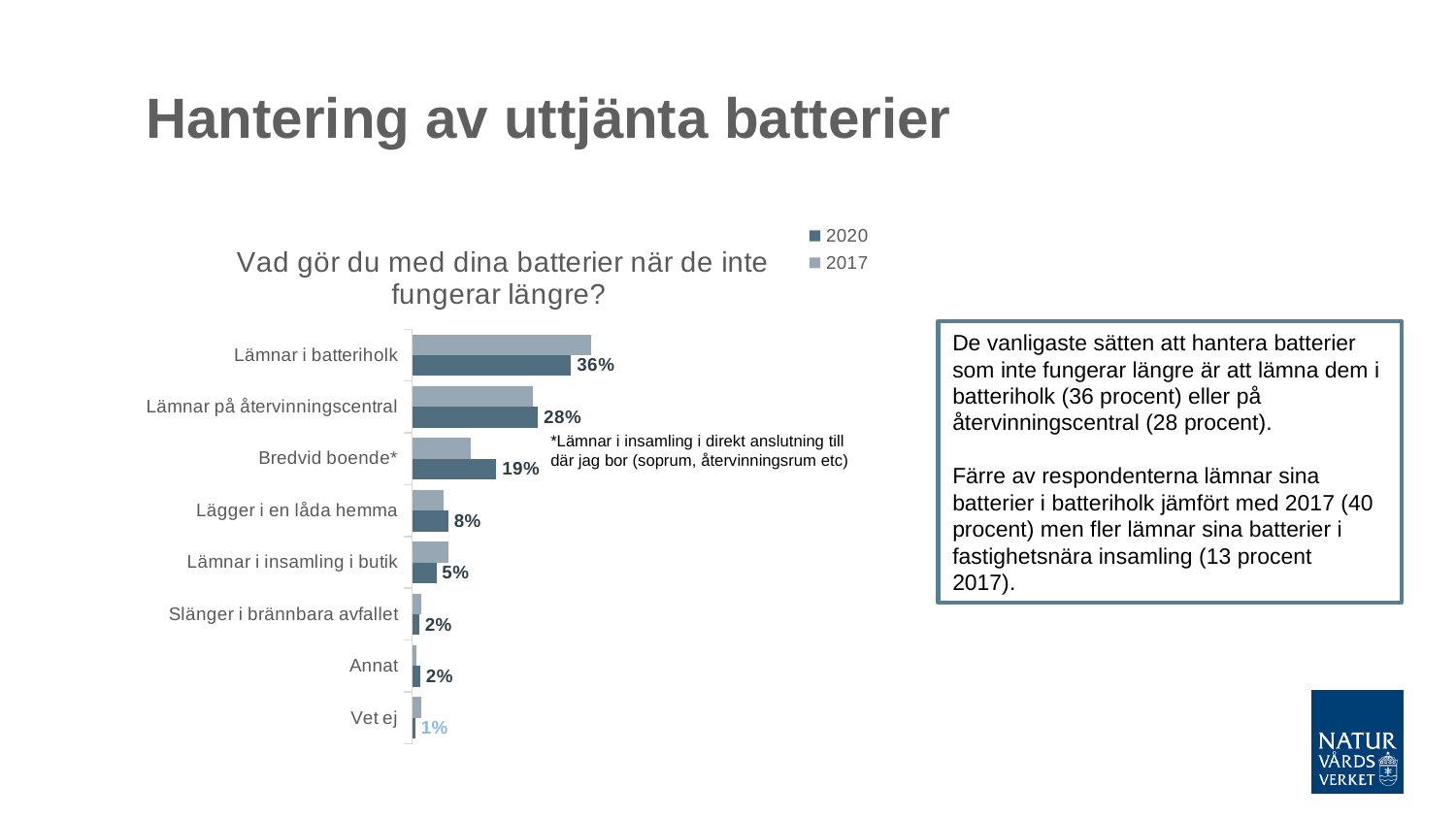
What is the title of the chart? Vad gör du med dina batterier när de inte fungerar längre? What is the 2020 value for "Bredvid boende*"? 19% Which category has the highest 2020 value? Lämnar i batteriholk What is the difference between the 2020 values for "Lämnar i batteriholk" and "Lämnar på återvinningscentral"? 8% What is the 2020 value for "Lämnar på återvinningscentral"? 28% How many categories are shown in the chart? 8 Which category has the lowest 2020 value? Vet ej What is the 2020 value for "Lämnar i insamling i butik"? 5% What kind of chart is shown on the slide? Bar chart How many series does the legend list? 2 What is the 2020 value for "Lämnar i batteriholk"? 36% For "Lämnar i batteriholk", which series has the larger value, 2020 or 2017? 2017